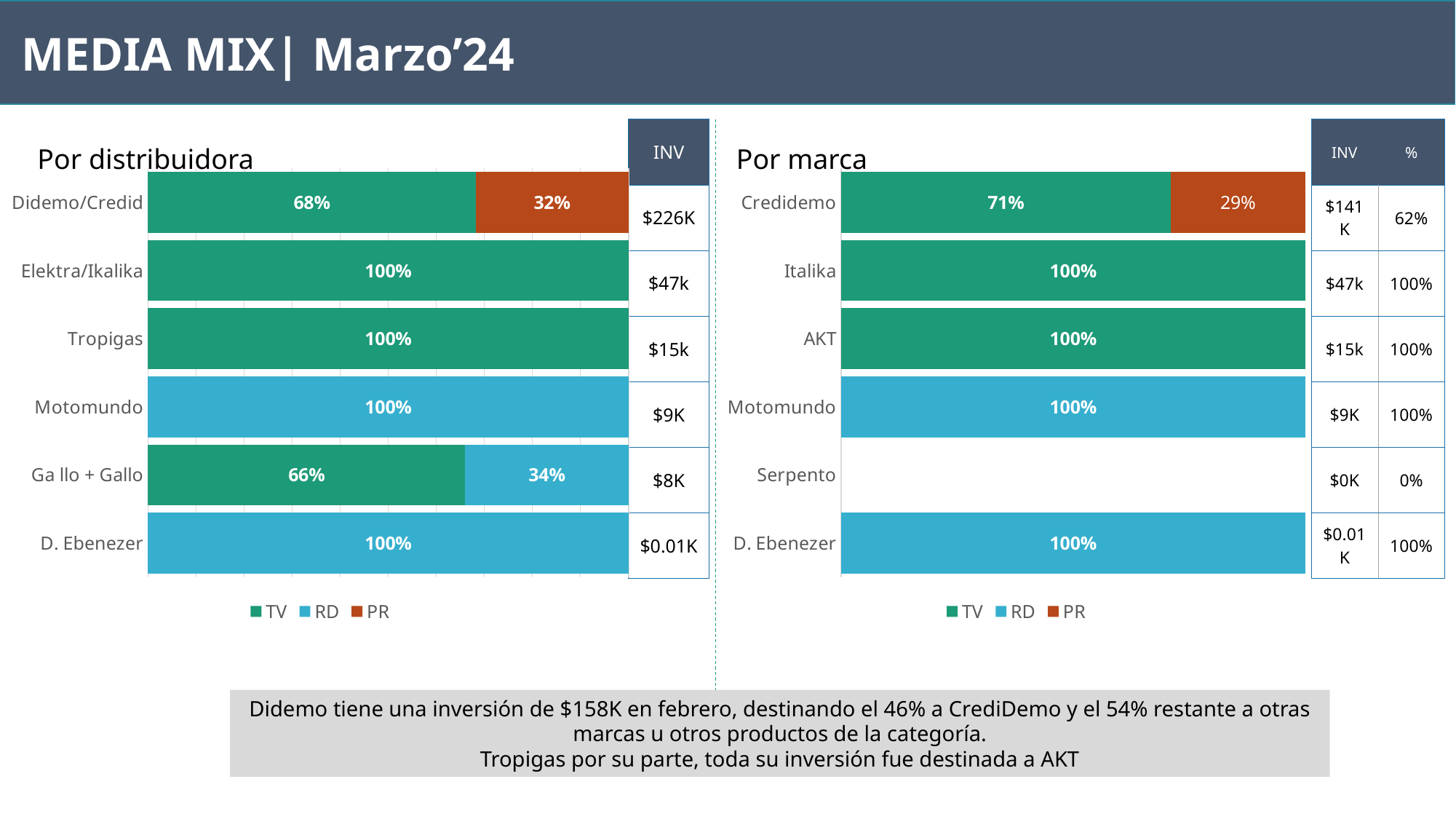
In the 'Por marca' chart, which is larger for Credidemo: the TV share or the PR share? TV In the 'Por distribuidora' chart, how many series does the legend list? 3 In the 'Por distribuidora' chart, what percentage of Didemo/Credid's media mix is PR? 32% In the 'Por marca' chart, what percentage of Credidemo's media mix is TV? 71% In the 'Por distribuidora' chart, how many distributors are listed? 6 In the 'Por marca' chart, what percentage of Credidemo's media mix is PR? 29% What kind of chart is the 'Por distribuidora' chart? Stacked bar chart In the 'Por marca' chart, which series does Motomundo's bar consist of entirely? RD In the 'Por distribuidora' chart, what percentage of Ga llo + Gallo's media mix is RD? 34% In the 'Por marca' chart, how many brands are listed? 6 In the 'Por distribuidora' chart, what percentage of Didemo/Credid's media mix is TV? 68% In the 'Por marca' chart, what is the difference between Credidemo's TV share and its PR share? 42%